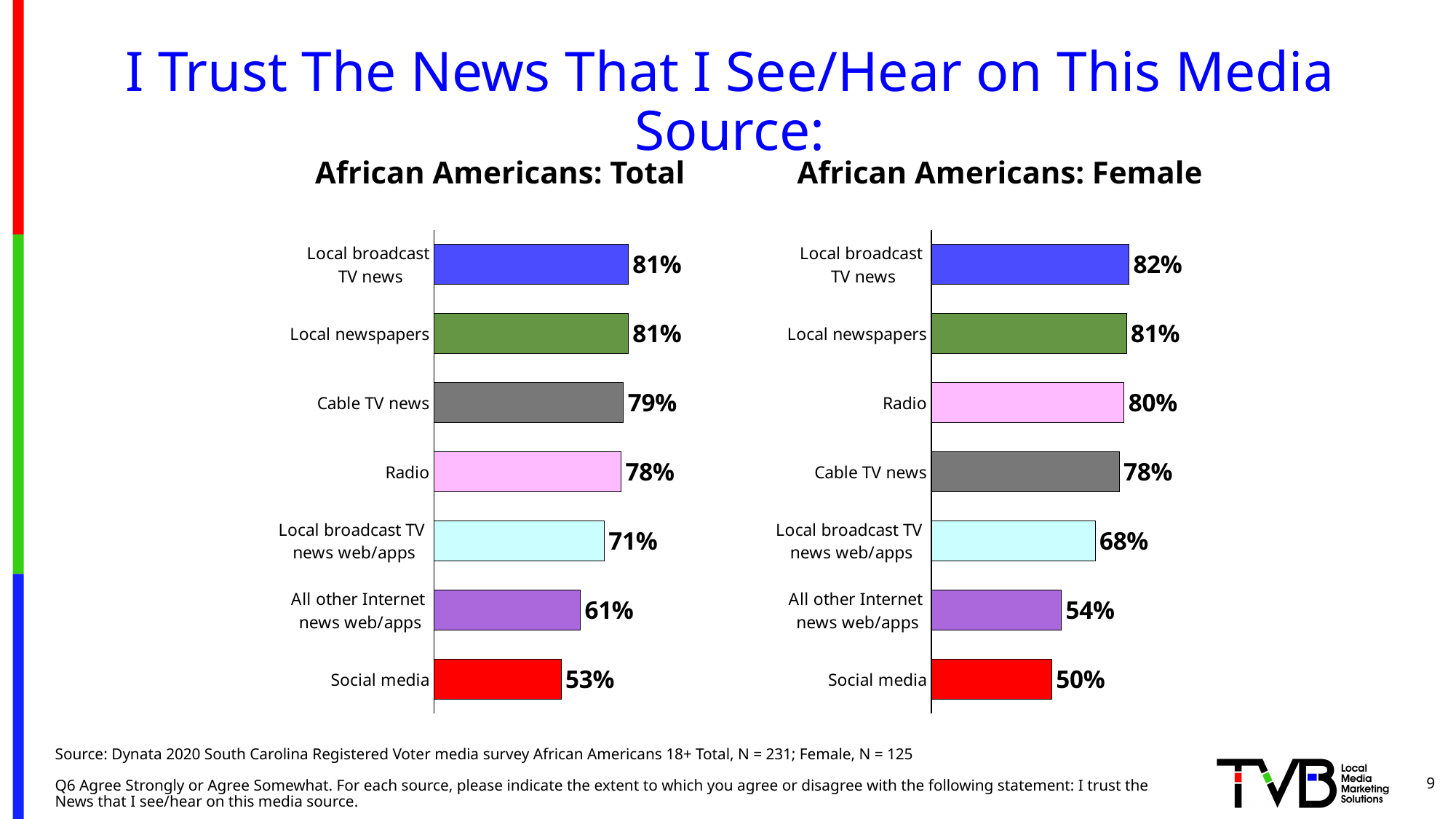
In the 'African Americans: Total' chart, which category has the lowest value? Social media How many categories are shown in the 'African Americans: Female' chart? 7 In the 'African Americans: Female' chart, what is the value for Local broadcast TV news web/apps? 68% What kind of chart is the 'African Americans: Total' chart? Bar chart In the 'African Americans: Female' chart, which category has the highest value? Local broadcast TV news In the 'African Americans: Female' chart, what is the value for Radio? 80% In the 'African Americans: Total' chart, what is the difference between Local broadcast TV news web/apps and Social media? 18% In the 'African Americans: Female' chart, what is the difference between Local newspapers and All other Internet news web/apps? 27% In the 'African Americans: Total' chart, what colour is the Social media bar? Red In the 'African Americans: Total' chart, what is the value for Cable TV news? 79% Which is larger: Social media in the 'African Americans: Total' chart or Social media in the 'African Americans: Female' chart? African Americans: Total In the 'African Americans: Total' chart, which is larger: Radio or All other Internet news web/apps? Radio